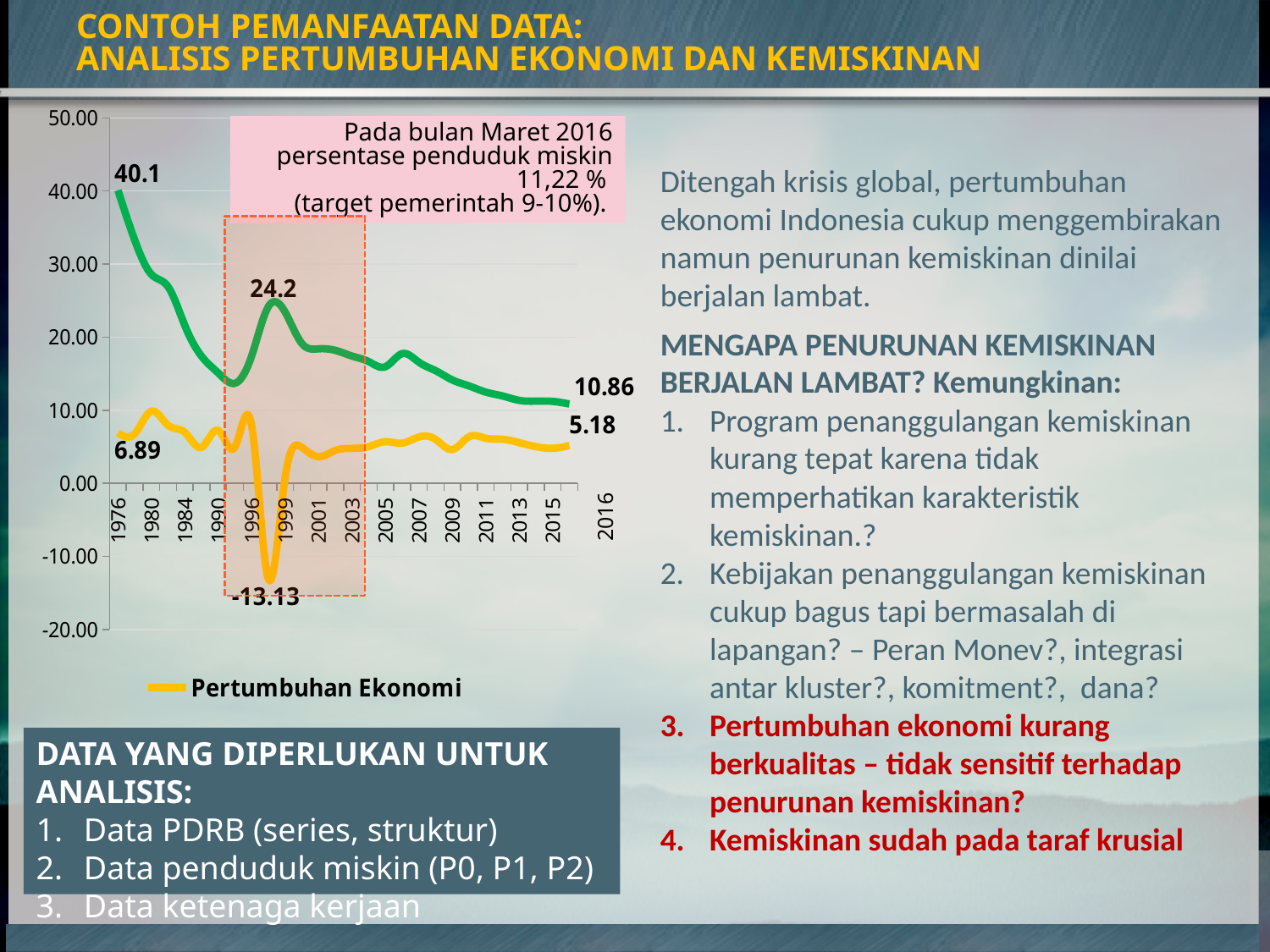
What is the value of Pertumbuhan Ekonomi in 1976? 6.89 What is the lowest labeled value of the Pertumbuhan Ekonomi line? -13.13 In 2016, what is the difference between the green line (10.86) and Pertumbuhan Ekonomi (5.18)? 5.68 What is the labeled peak value of the green line around 1999? 24.2 Is the value of the green line in 2007 greater or less than 20.00? less What kind of chart is shown on the slide? line chart What is the difference between the green line's value in 1976 (40.1) and in 2016 (10.86)? 29.24 What is the value of the green line in 2016? 10.86 What is the value of the green line in 1976? 40.1 In 2016, which is larger: the green line or Pertumbuhan Ekonomi? the green line What is the value of Pertumbuhan Ekonomi in 2016? 5.18 Does the green line overall rise or fall from 1976 to 2016? fall